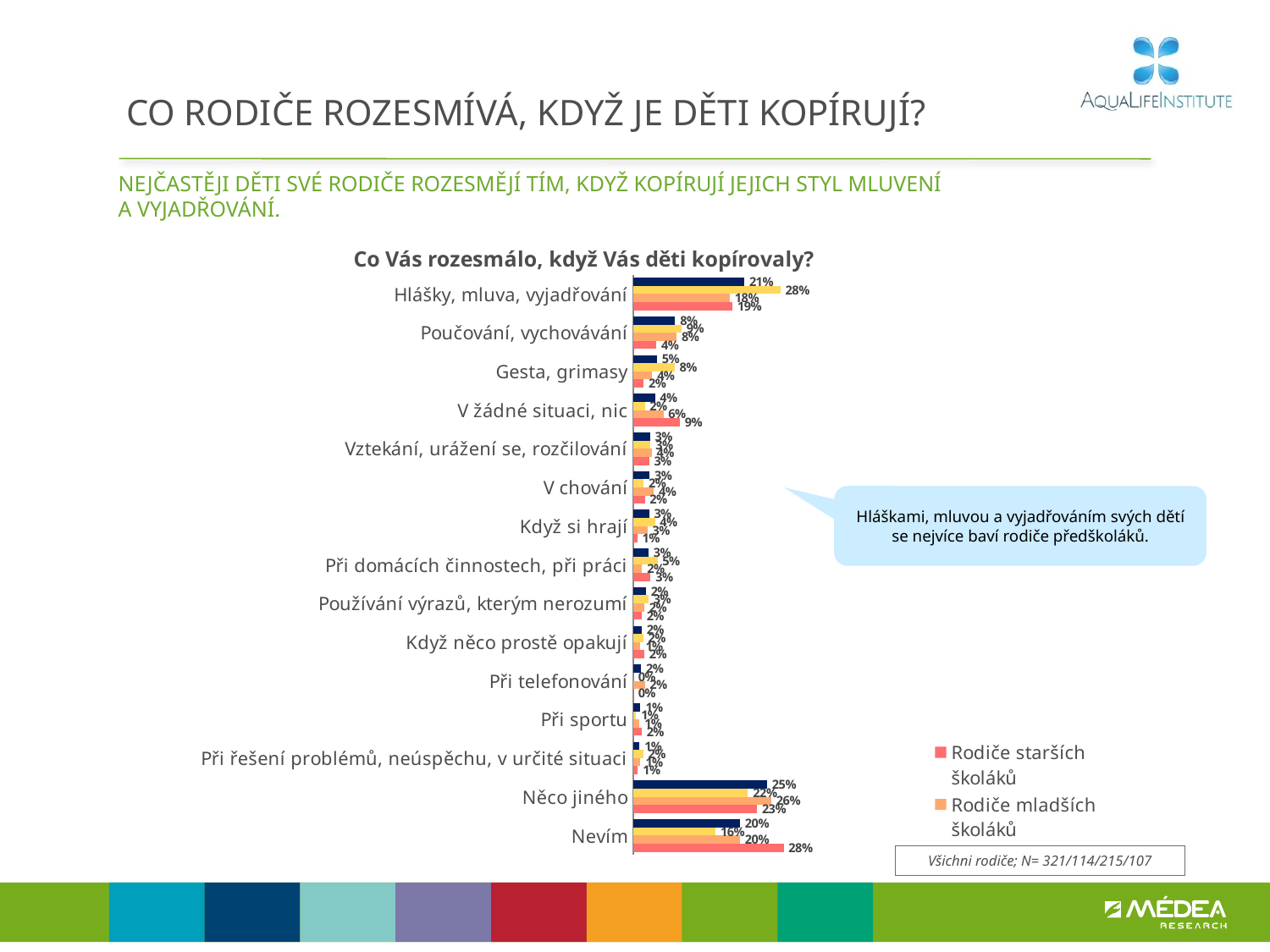
What is the value for Rodiče starších školáků in the category V žádné situaci, nic? 9% How many bars are plotted for each category? 4 What is the value for Rodiče mladších školáků in the category Něco jiného? 26% For Rodiče starších školáků, which category has the highest value? Nevím How many categories are listed on the chart's vertical axis? 15 What is the value for Rodiče mladších školáků in the category Hlášky, mluva, vyjadřování? 18% What is the title of the chart? Co Vás rozesmálo, když Vás děti kopírovaly? What is the value for Rodiče starších školáků in the category Nevím? 28% For Rodiče mladších školáků, which is larger: Něco jiného or Nevím? Něco jiného What kind of chart is shown on the slide? bar chart What is the value for Rodiče starších školáků in the category Hlášky, mluva, vyjadřování? 19% For Rodiče starších školáků, what is the difference between the values for Nevím and Hlášky, mluva, vyjadřování? 9 percentage points